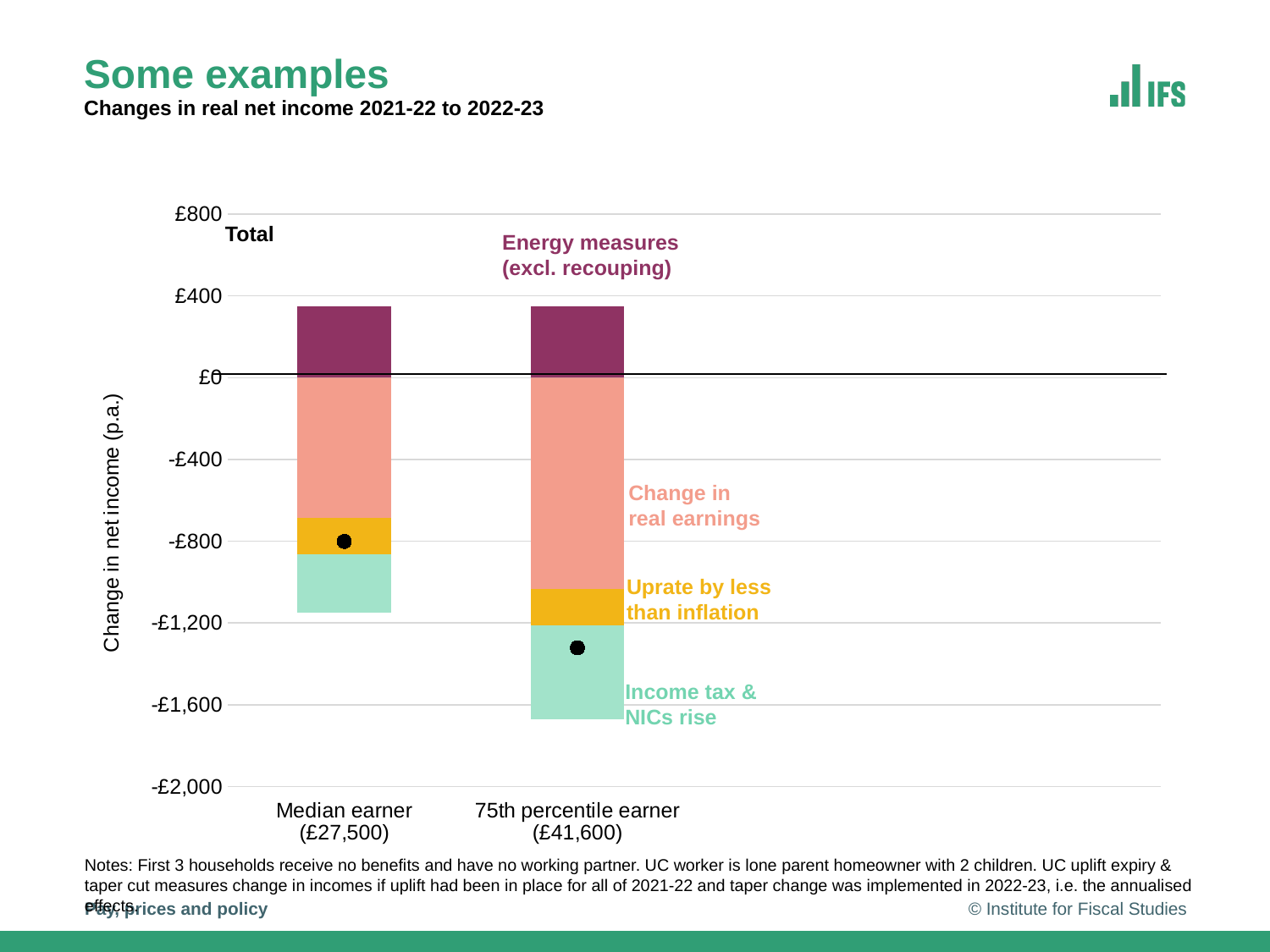
What kind of chart is shown on the slide? Stacked bar chart Which earner has the larger Income tax & NICs rise segment? 75th percentile earner (£41,600) Is the bottom of the stacked bar for the Median earner greater or less than -£1,200? greater Is the Energy measures (excl. recouping) value for the Median earner greater or less than £400? less Is the Change in real earnings for the Median earner greater or less than -£800? greater What is the label on the y axis? Change in net income (p.a.) How many earner categories are shown on the x axis? 2 Which earner has the larger overall fall in net income (lower Total)? 75th percentile earner (£41,600) How many income-change components are labelled on the chart (excluding the Total marker)? 4